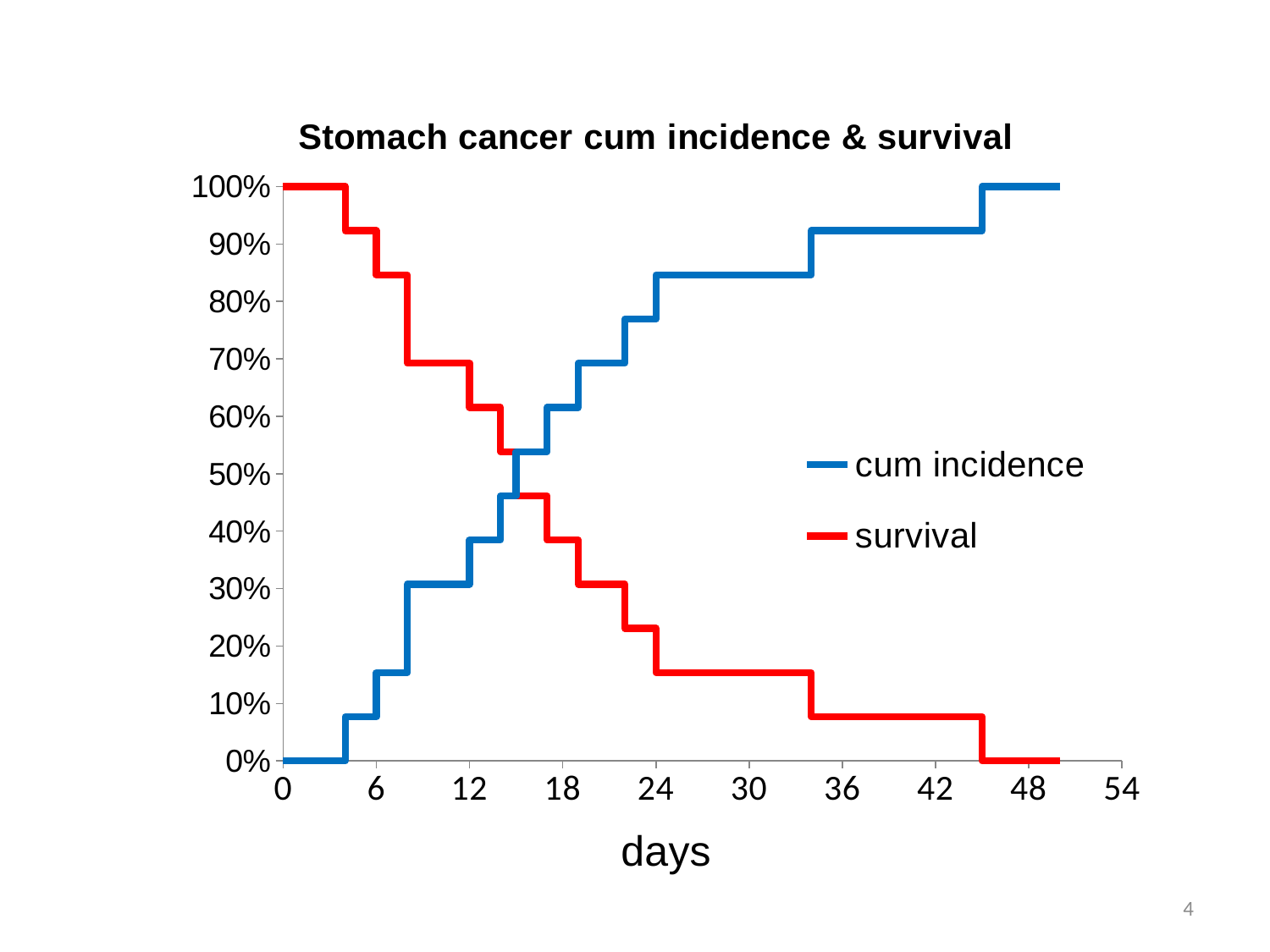
Is the survival value at day 30 greater or less than 20%? less Does the survival series rise or fall as days increase? fall What kind of chart is shown on the slide? line chart What is the survival value at day 0? 100% What is the title of the chart? Stomach cancer cum incidence & survival Is the cum incidence value at day 30 greater or less than 80%? greater What is the label of the x axis? days Does the cum incidence series rise or fall as days increase? rise What is the cum incidence value at day 48? 100% How many series does the legend list? 2 What is the cum incidence value at day 0? 0% What is the survival value at day 48? 0%